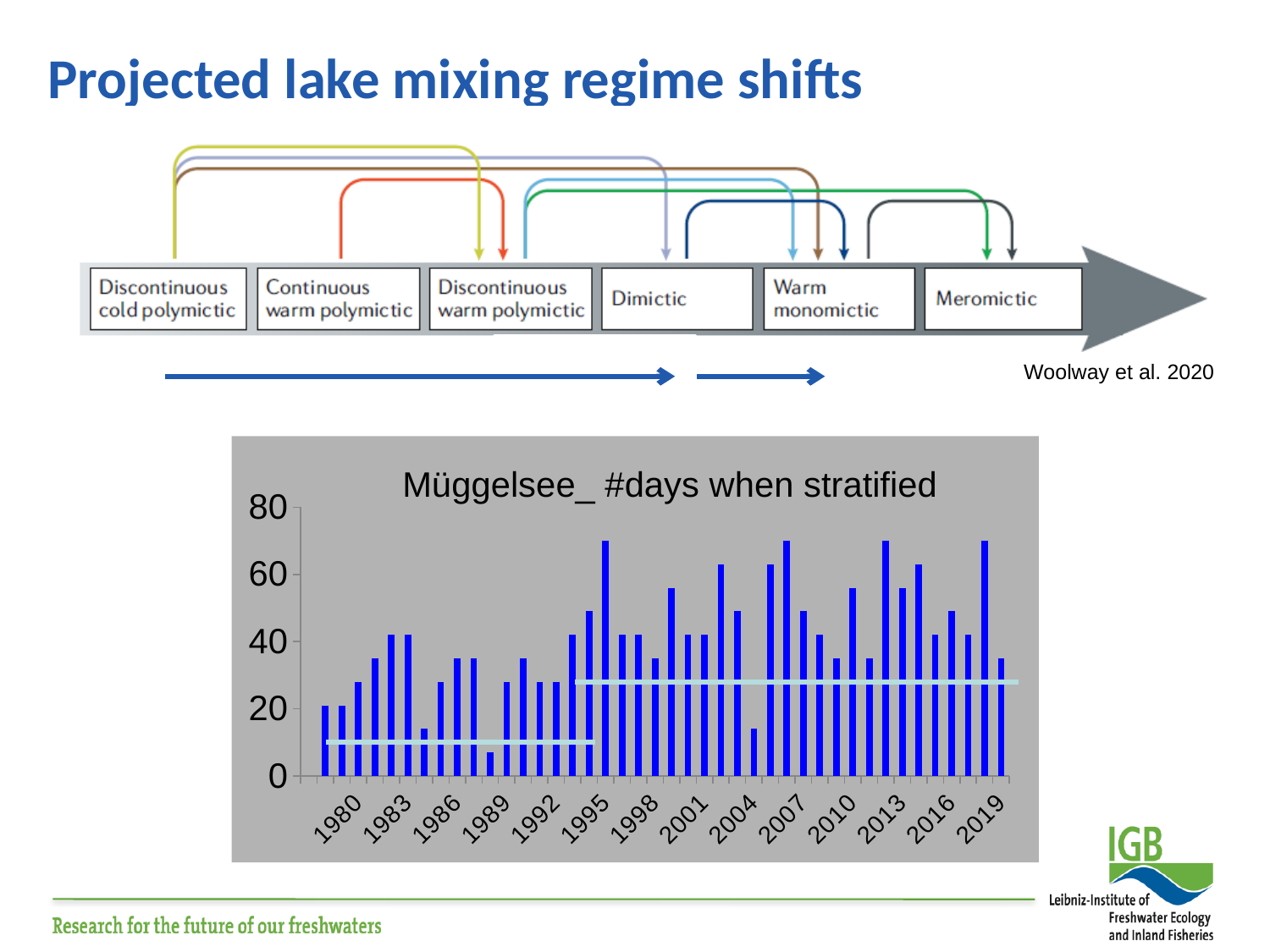
In the Müggelsee bar chart, is the value of the tallest bar greater or less than 80? less In the Müggelsee bar chart, do the number of stratified days generally rise or fall from 1980 to 2019? rise In the Müggelsee bar chart, is the value of the tallest bar greater or less than 60? greater In the Müggelsee bar chart, is the value for the first bar (around 1980) greater or less than 40? less What is the title of the bar chart on the slide? Müggelsee_ #days when stratified What is the highest value shown on the y axis of the Müggelsee bar chart? 80 What kind of chart is shown on the slide under the title "Müggelsee_ #days when stratified"? bar chart